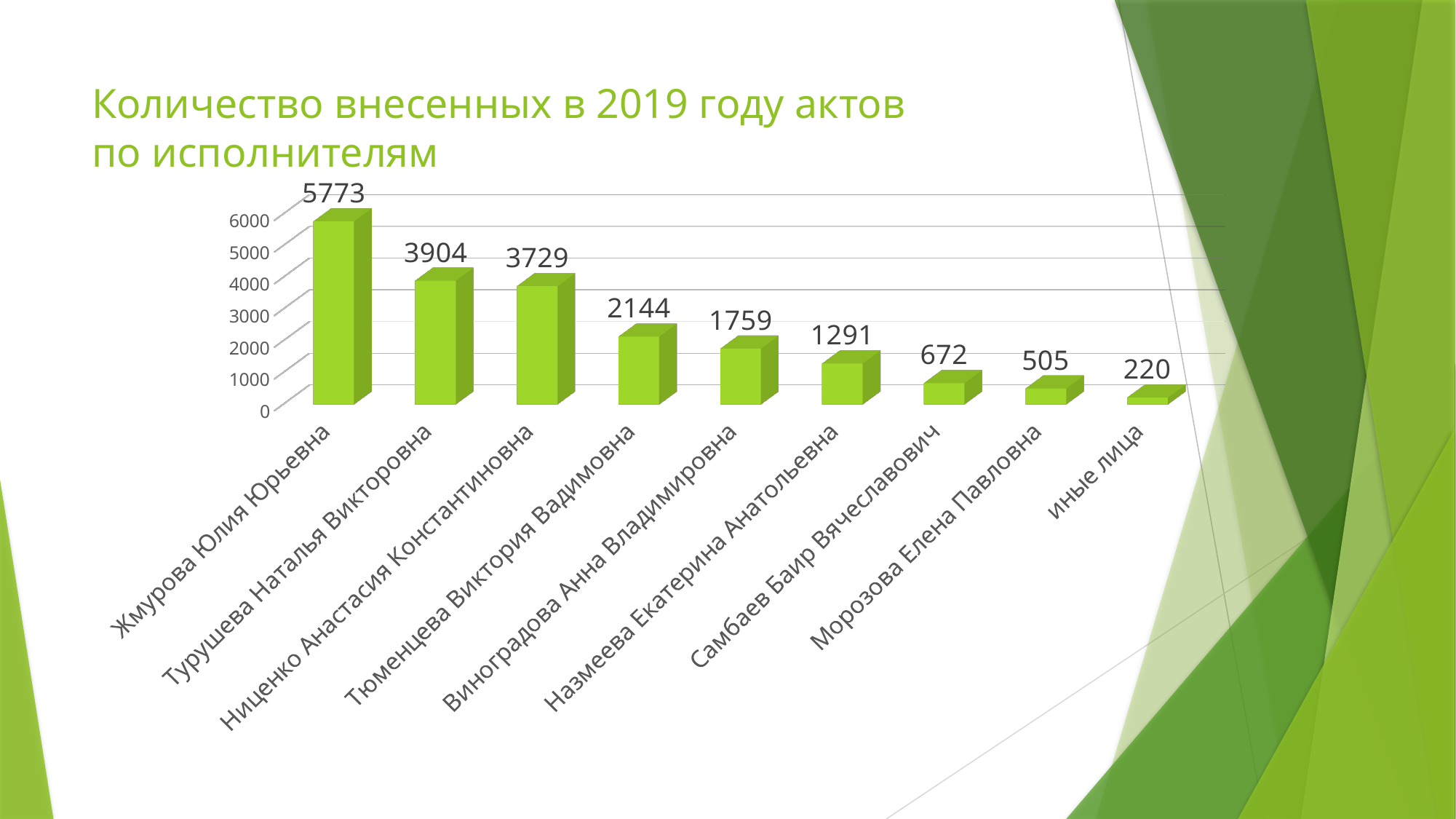
Which category has the lowest value? иные лица Which is larger, the value for Виноградова Анна Владимировна or the value for Назмеева Екатерина Анатольевна? Виноградова Анна Владимировна Do the values rise or fall from left to right along the x axis? fall Is the value for Самбаев Баир Вячеславович greater or less than 1000? less Which category has the highest value? Жмурова Юлия Юрьевна How many categories are shown on the x axis? 9 What is the title of the chart on the slide? Количество внесенных в 2019 году актов по исполнителям What is the difference between the values for Турушева Наталья Викторовна and Ниценко Анастасия Константиновна? 175 What value is shown for иные лица? 220 What value is shown for Тюменцева Виктория Вадимовна? 2144 What kind of chart is shown on the slide? bar chart What value is shown for Жмурова Юлия Юрьевна? 5773